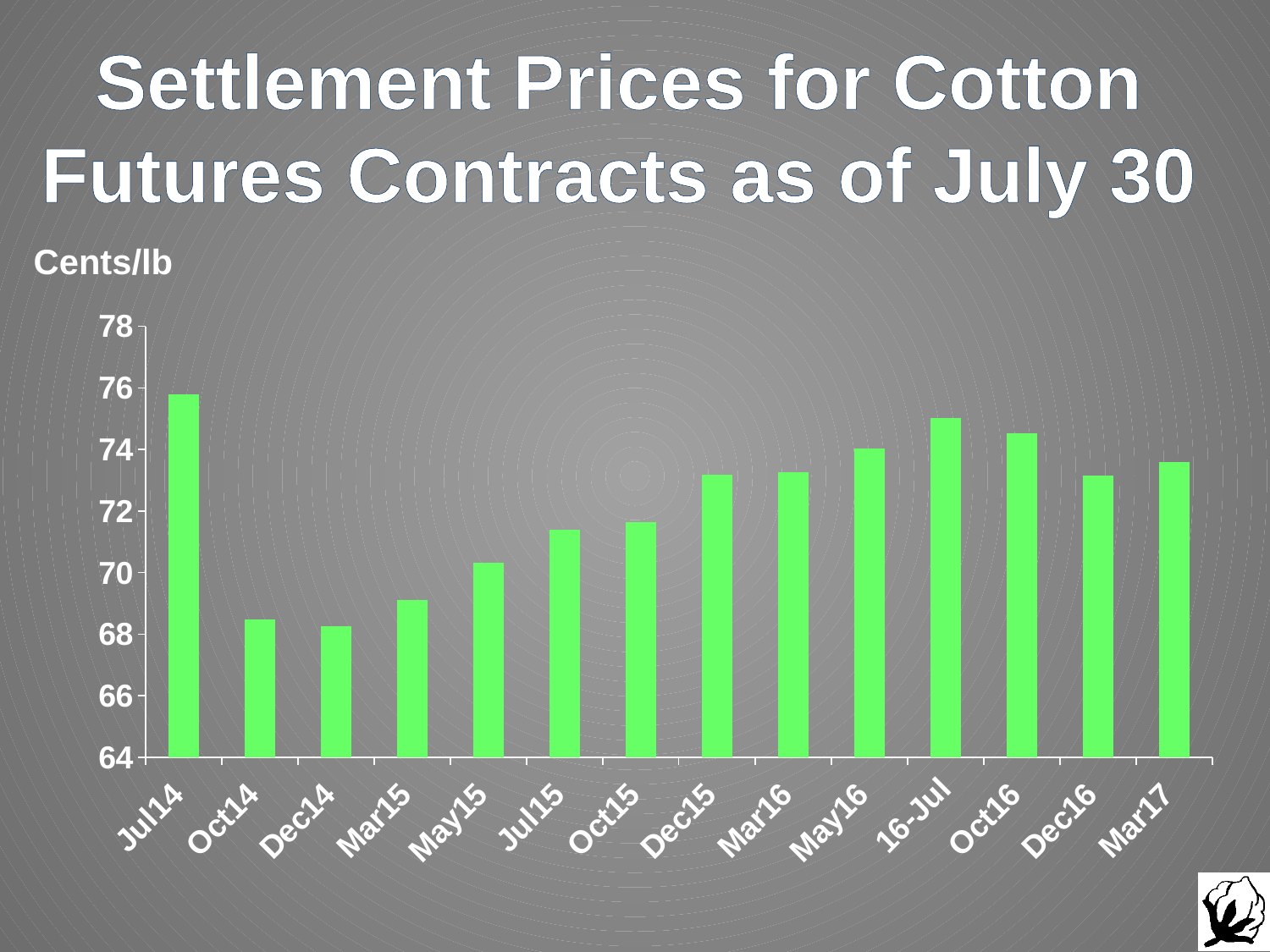
Is the value for Oct14 greater or less than 70? less Is the value for Oct16 greater or less than 74? greater Do the settlement prices generally rise or fall from Dec14 to 16-Jul? rise Which is larger, the value for 16-Jul or the value for Dec16? 16-Jul How many contract months are plotted on the chart? 14 Is the value for Mar17 greater or less than 74? less Which is larger, the value for Mar15 or the value for Jul15? Jul15 Which contract month has the highest settlement price? Jul14 What kind of chart is shown on the slide? bar chart What unit is the vertical axis measured in? Cents/lb